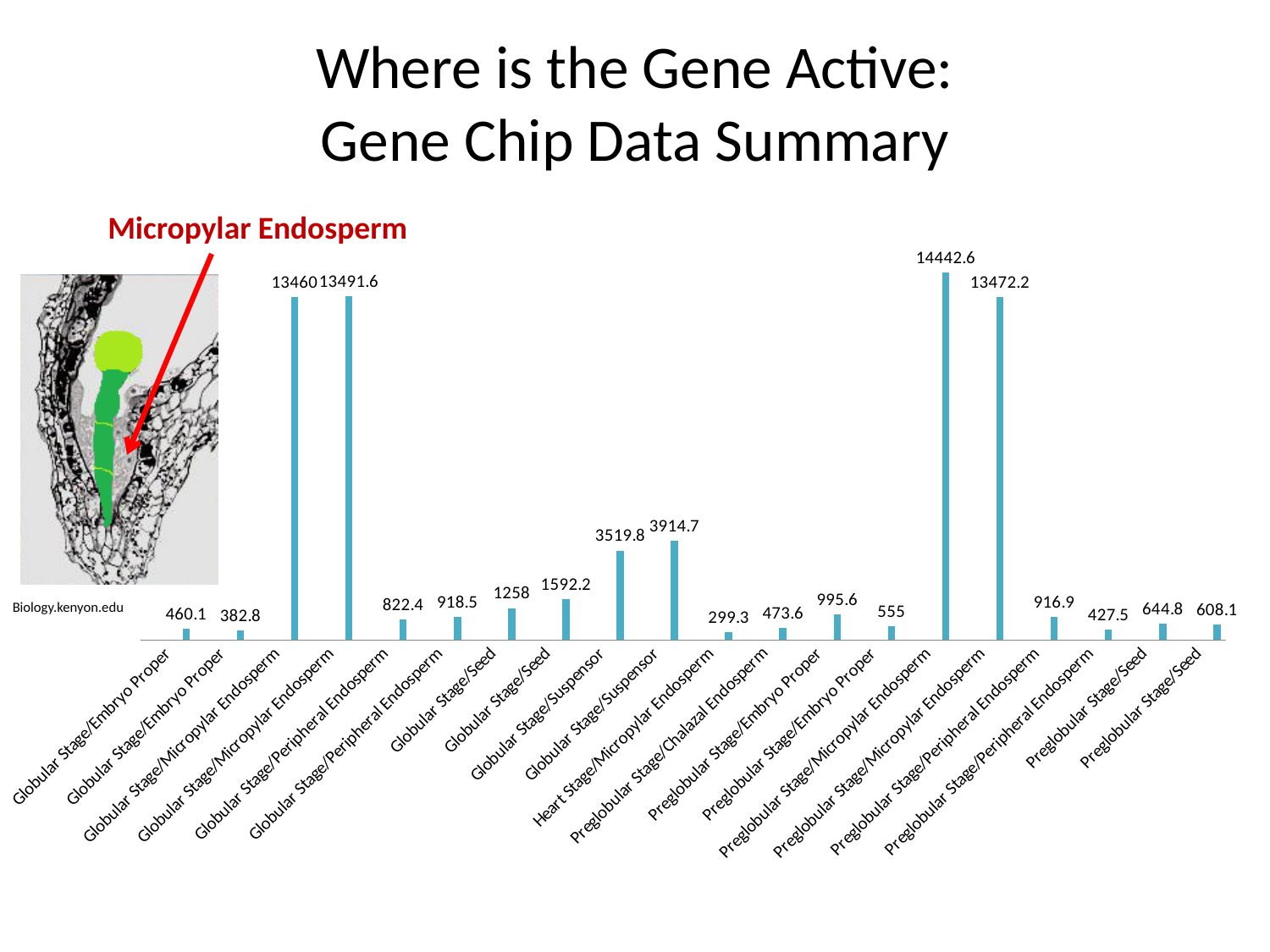
What tissue does the red arrow on the slide point to? Micropylar Endosperm What is the highest value shown in the chart? 14442.6 What is the difference between the two Preglobular Stage/Micropylar Endosperm bars (14442.6 and 13472.2)? 970.4 What kind of chart is shown on the slide? bar chart What is the value for Preglobular Stage/Chalazal Endosperm? 473.6 What is the value of the first Globular Stage/Micropylar Endosperm bar? 13460 Which is larger, the value for Heart Stage/Micropylar Endosperm or the value for Preglobular Stage/Chalazal Endosperm? Preglobular Stage/Chalazal Endosperm How many bars are plotted in the chart? 20 What is the value for Heart Stage/Micropylar Endosperm? 299.3 What is the difference between the two Globular Stage/Suspensor bars (3914.7 and 3519.8)? 394.9 Which category has the lowest value in the chart? Heart Stage/Micropylar Endosperm Which category has the highest value in the chart? Preglobular Stage/Micropylar Endosperm